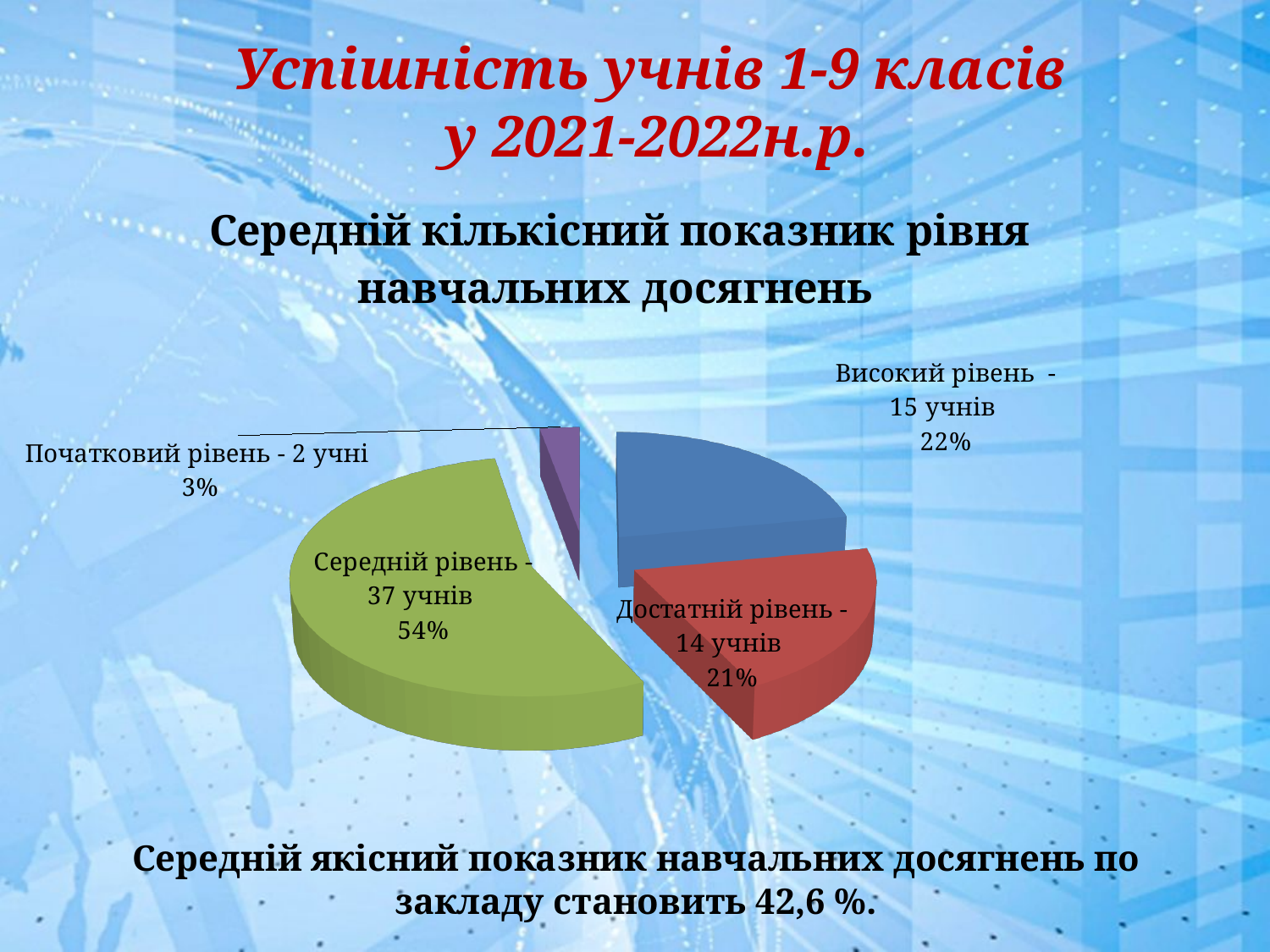
What is the difference in the number of students between "Середній рівень" and "Високий рівень"? 22 Which has more students, "Високий рівень" or "Достатній рівень"? Високий рівень Which category has the smallest share of the pie? Початковий рівень How many students are in the "Високий рівень" category? 15 учнів What percentage of the pie does "Середній рівень" represent? 54% How many students are in the "Достатній рівень" category? 14 учнів Which category has the largest share of the pie? Середній рівень How many slices does the pie chart have? 4 What kind of chart is shown on the slide? Pie chart What is the total number of students across all four categories in the pie chart? 68 What percentage of the pie does "Початковий рівень" represent? 3% What colour is the slice for "Середній рівень"? Green